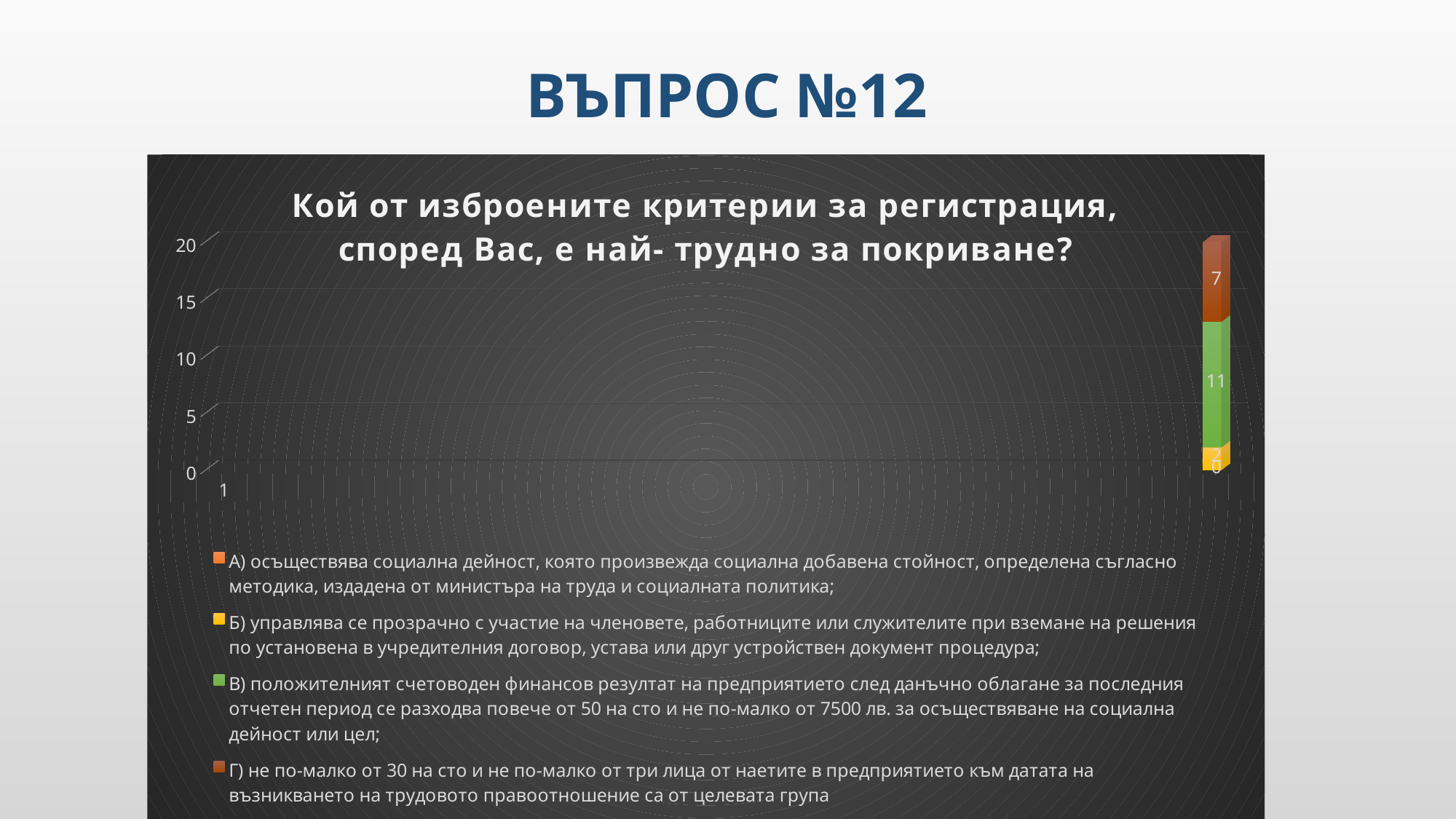
Which is larger, the value for series Г) or the value for series Б)? Г) What is the value for series В) (the green segment)? 11 What is the total of the stacked bar? 20 What is the value for series Б) (the yellow segment)? 2 What kind of chart is shown on the slide? bar chart Which series has the lowest value? А) Which series has the highest value? В) What is the value for series А) (the orange segment)? 0 What is the value for series Г) (the top, brown segment)? 7 What is the difference between the values for series В) and series Г)? 4 What is the title of the chart? Кой от изброените критерии за регистрация, според Вас, е най- трудно за покриване? How many series does the legend list? 4